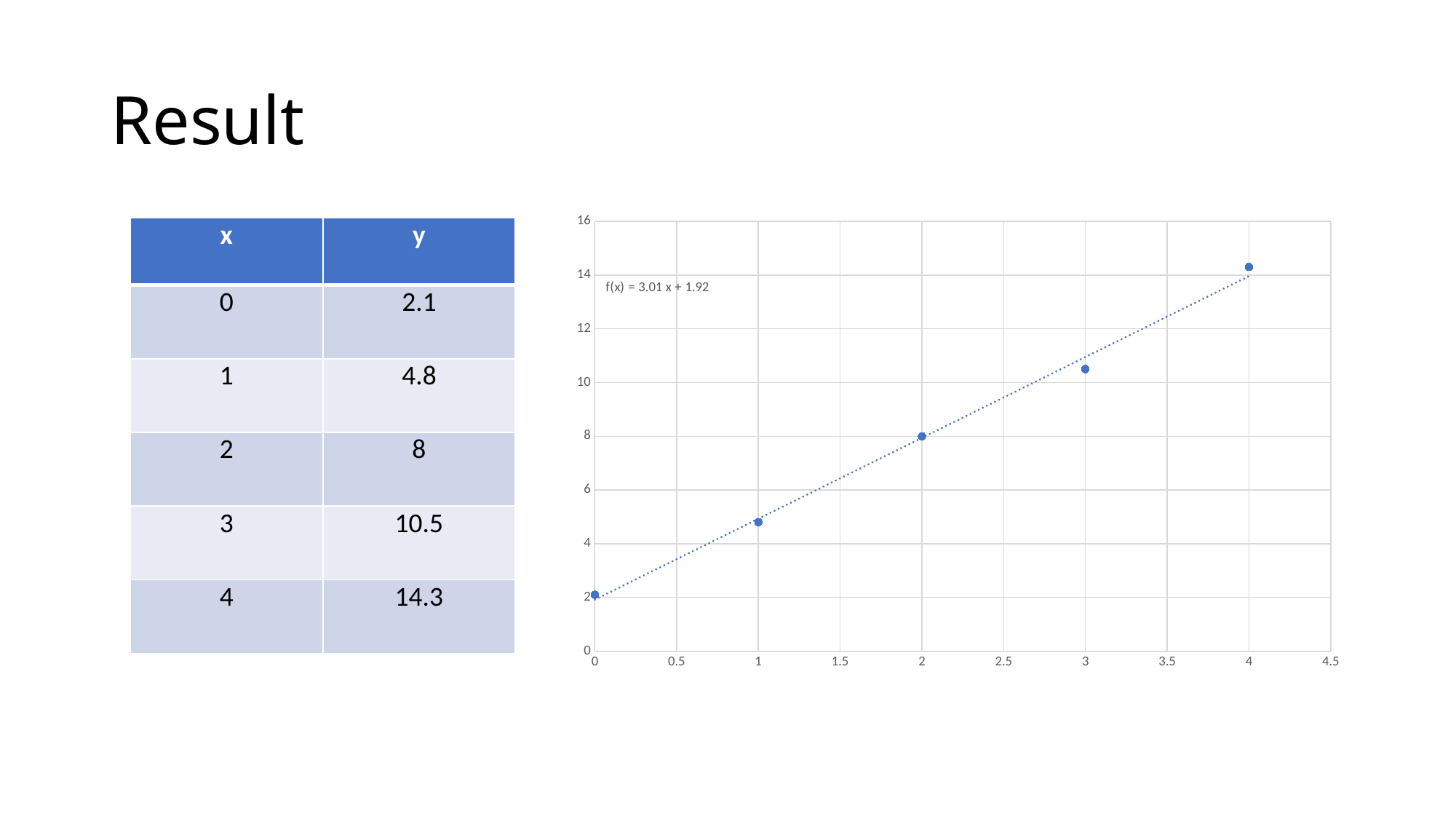
At which x value is the plotted y value highest? 4 Which has the larger plotted y value, x = 1 or x = 3? x = 3 What is the highest value shown on the chart's y axis? 16 Is the plotted y value at x = 3 greater or less than 10? greater Is the plotted y value at x = 1 greater or less than 6? less At which x value is the plotted y value lowest? 0 What is the plotted y value at x = 2? 8 How many data points are plotted on the chart? 5 What kind of chart is shown on the slide? scatter chart Do the plotted y values rise or fall as x increases along the x axis? rise Is the plotted y value at x = 4 greater or less than 12? greater What is the trendline equation shown on the chart? f(x) = 3.01 x + 1.92